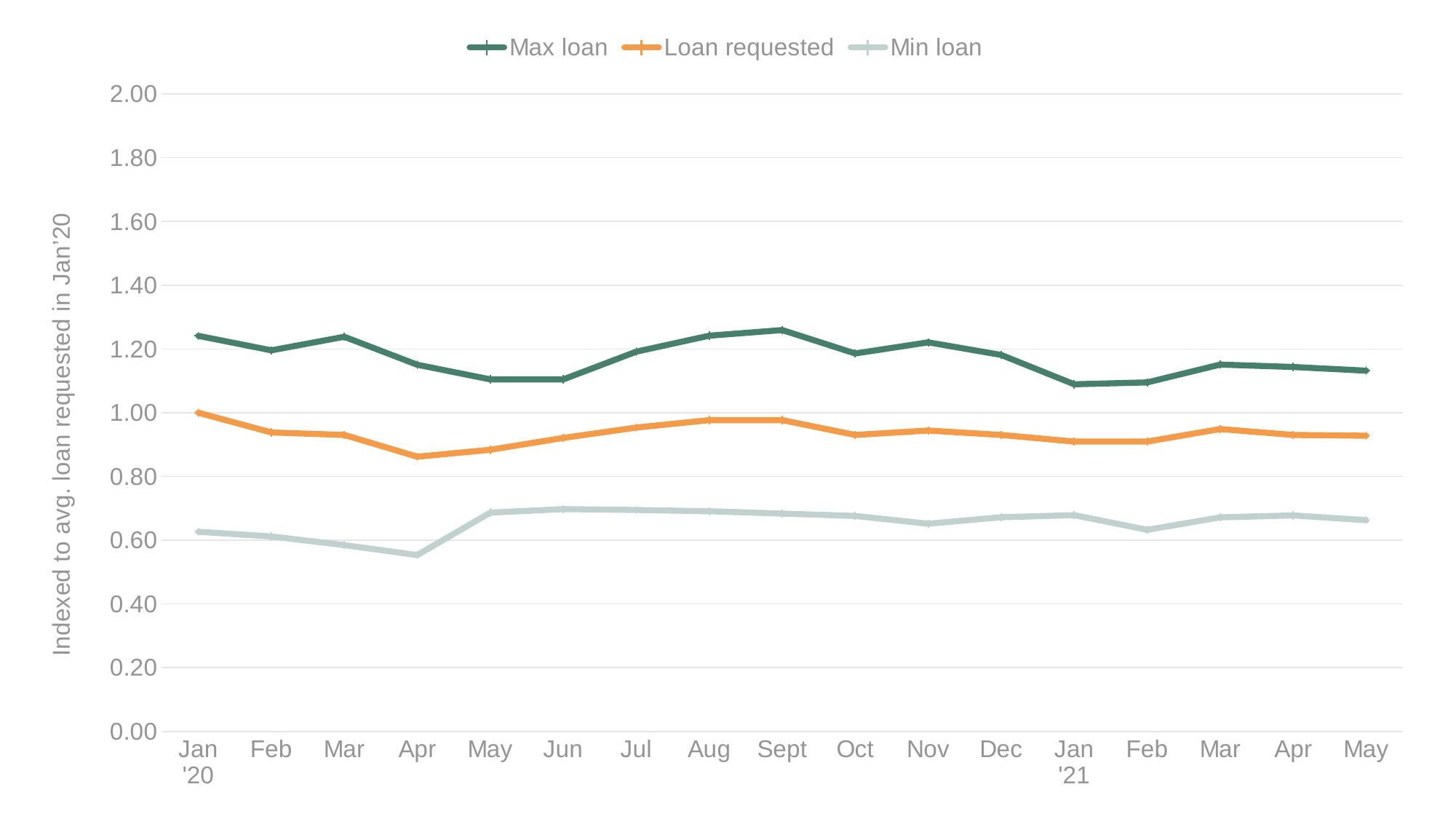
Does the Min loan series rise or fall from Jan '20 to Apr '20? Fall Is the value for Max loan in Jan '21 greater or less than 1.20? less What is the label on the y axis? Indexed to avg. loan requested in Jan'20 Which is larger in Sept '20: Max loan or Min loan? Max loan In which month is the Min loan series at its lowest? Apr '20 What kind of chart is shown on the slide? Line chart What is the value of Loan requested in Jan '20? 1.00 How many series does the legend list? 3 Is the value for Max loan in Jan '20 greater or less than 1.20? greater In which month is the Loan requested series at its lowest? Apr '20 How many months are plotted along the x axis? 17 Is the value for Min loan in Apr '20 greater or less than 0.60? less